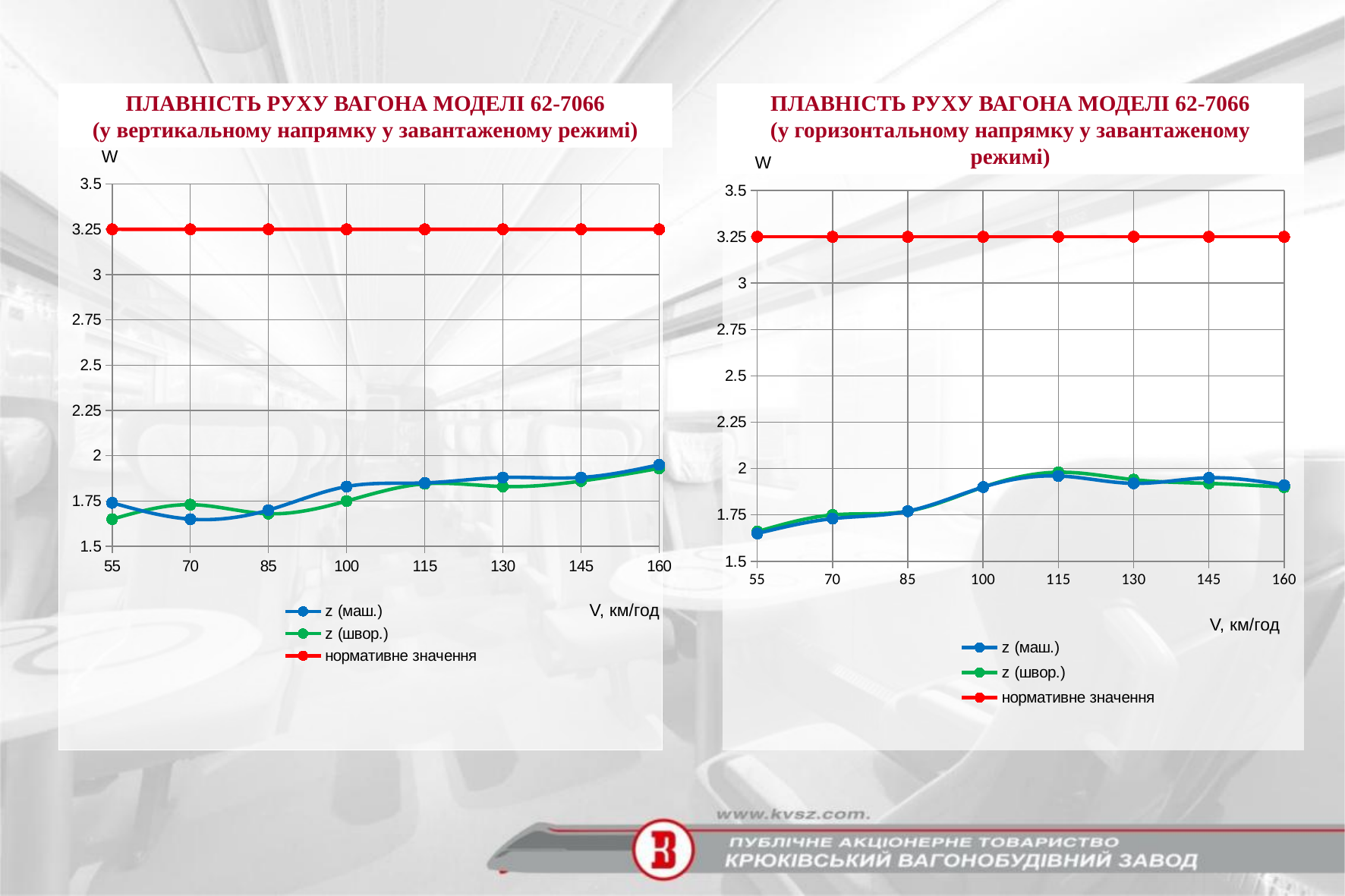
In the right chart (у горизонтальному напрямку), what is the value of нормативне значення at 160 км/год? 3.25 How many speed values are plotted along the x axis of the left chart (у вертикальному напрямку)? 8 In the left chart (у вертикальному напрямку), is the value of z (швор.) at 55 км/год greater or less than 1.75? less In the left chart (у вертикальному напрямку), is the value of z (маш.) at 160 км/год greater or less than 2? less In the right chart (у горизонтальному напрямку), is the value of z (маш.) at 55 км/год greater or less than 1.75? less In the left chart (у вертикальному напрямку), at which speed does z (маш.) reach its highest value? 160 What type of chart is the left chart (у вертикальному напрямку)? line chart In the right chart (у горизонтальному напрямку), which is larger at 130 км/год: нормативне значення or z (маш.)? нормативне значення In the left chart (у вертикальному напрямку), what is the value of нормативне значення at 100 км/год? 3.25 In the left chart (у вертикальному напрямку), does z (маш.) generally rise or fall as speed increases from 55 to 160 км/год? rise How many series does the legend of the right chart (у горизонтальному напрямку) list? 3